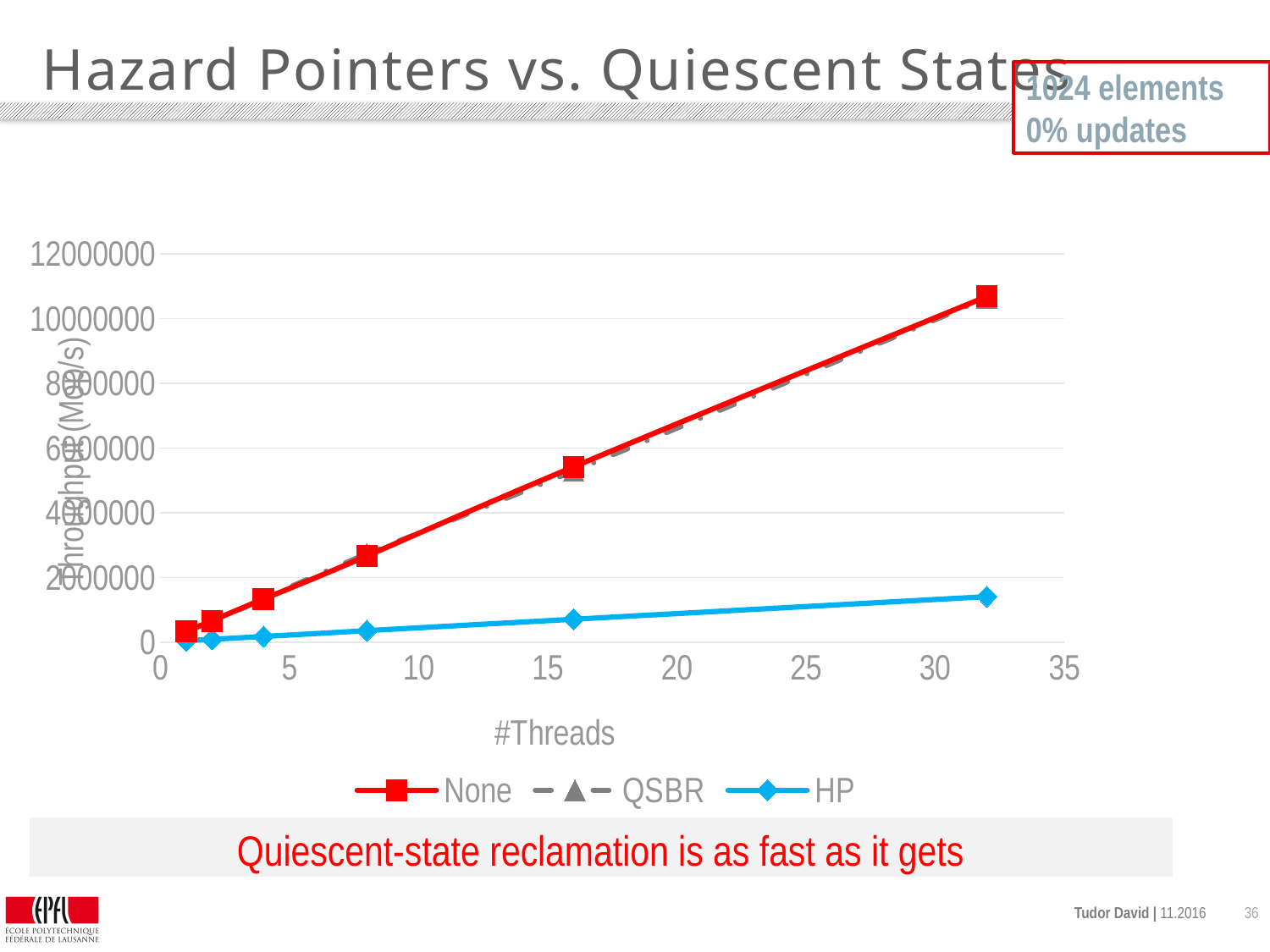
What is the label of the x axis? #Threads At 32 threads, which series has the higher throughput, None or HP? None How many data points are plotted for the HP series? 6 Is the value for the None series at 32 threads greater or less than 10000000? greater How many series does the legend list? 3 Does the throughput of the HP series rise or fall as the number of threads increases? rise Does the throughput of the None series rise or fall as the number of threads increases? rise What kind of chart is shown on the slide? line chart Is the value for the HP series at 32 threads greater or less than 2000000? less Is the value for the None series at 16 threads greater or less than 4000000? greater What are the three series named in the legend? None, QSBR, HP